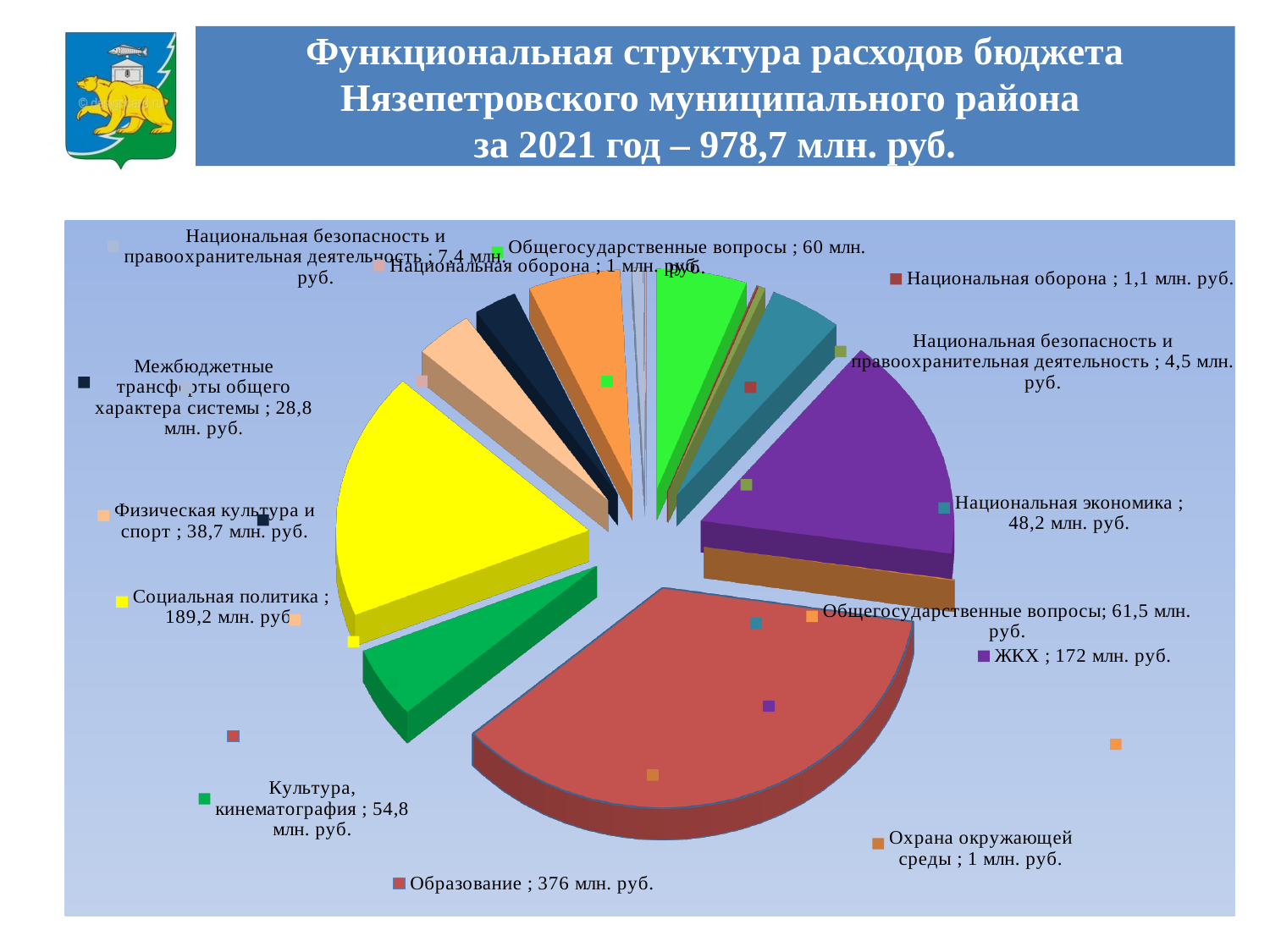
Which category has the largest slice of the pie? Образование What is the difference between Образование and Социальная политика? 186,8 млн. руб. What is the value for Культура, кинематография? 54,8 млн. руб. What is the value for Охрана окружающей среды? 1 млн. руб. What is the value for Образование? 376 млн. руб. What is the value for Социальная политика? 189,2 млн. руб. Which is larger, Социальная политика or ЖКХ? Социальная политика What kind of chart is shown on the slide? Pie chart What is the value for ЖКХ? 172 млн. руб. What is the value for Физическая культура и спорт? 38,7 млн. руб. What is the value for Национальная экономика? 48,2 млн. руб. What total budget expenditure for 2021 is stated in the slide title? 978,7 млн. руб.